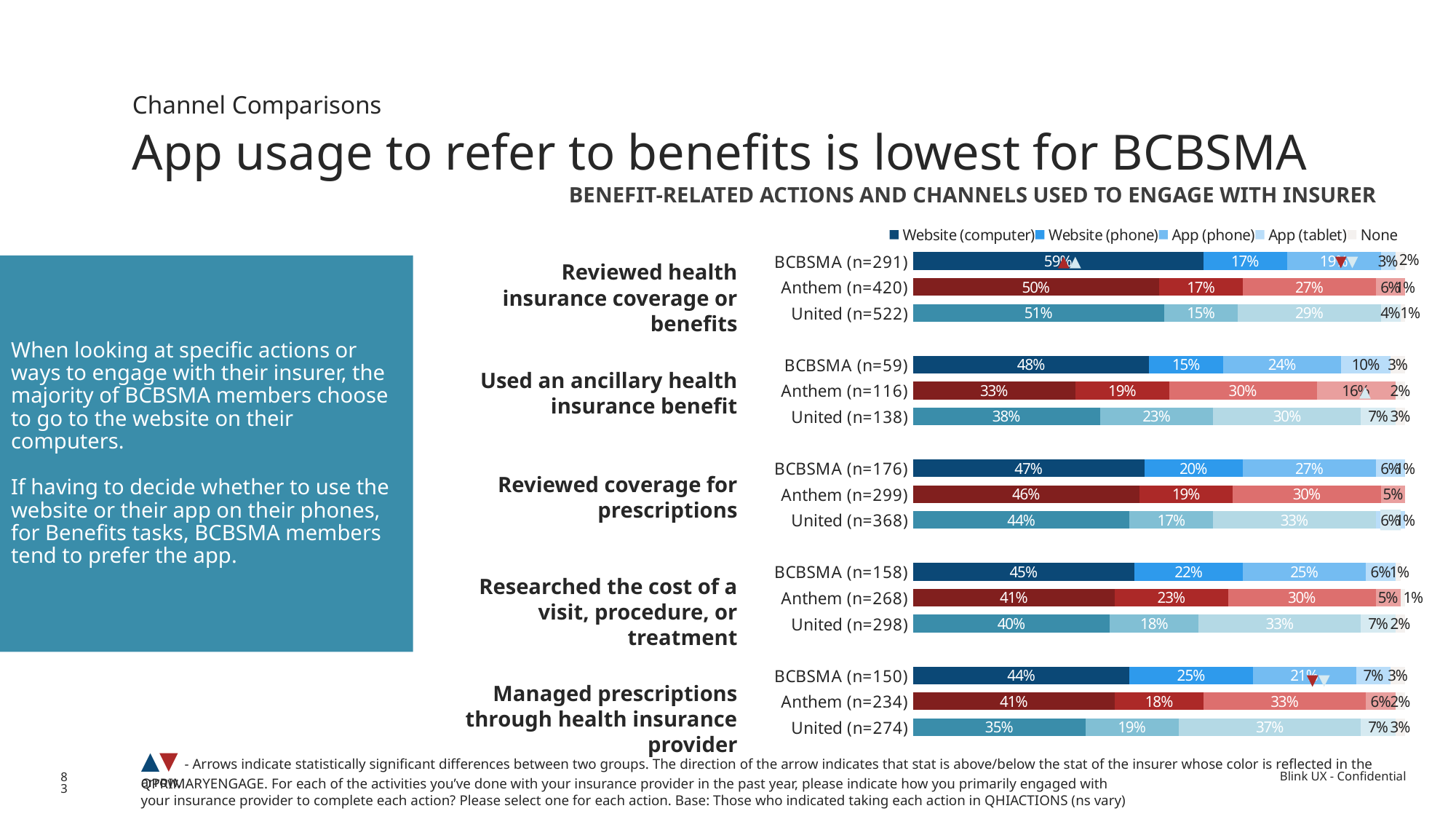
What is the App (tablet) value for Anthem (n=116) under 'Used an ancillary health insurance benefit'? 16% What is the Website (phone) value for BCBSMA (n=150) under 'Managed prescriptions through health insurance provider'? 25% What is the title of the chart? BENEFIT-RELATED ACTIONS AND CHANNELS USED TO ENGAGE WITH INSURER What kind of chart is shown on the slide? Stacked bar chart How many benefit-related actions are shown in the chart? 5 What is the App (phone) value for United (n=274) under 'Managed prescriptions through health insurance provider'? 37% Under 'Researched the cost of a visit, procedure, or treatment', which is larger: the App (phone) value for United (n=298) or for BCBSMA (n=158)? United (n=298) Under 'Managed prescriptions through health insurance provider', which insurer has the lowest Website (computer) value? United (n=274) How many series does the chart legend list? 5 What is the difference between the Website (computer) values for BCBSMA (n=291) and Anthem (n=420) under 'Reviewed health insurance coverage or benefits'? 9% What is the Website (computer) value for BCBSMA (n=291) under 'Reviewed health insurance coverage or benefits'? 59% Under 'Used an ancillary health insurance benefit', which insurer has the highest Website (computer) value? BCBSMA (n=59)